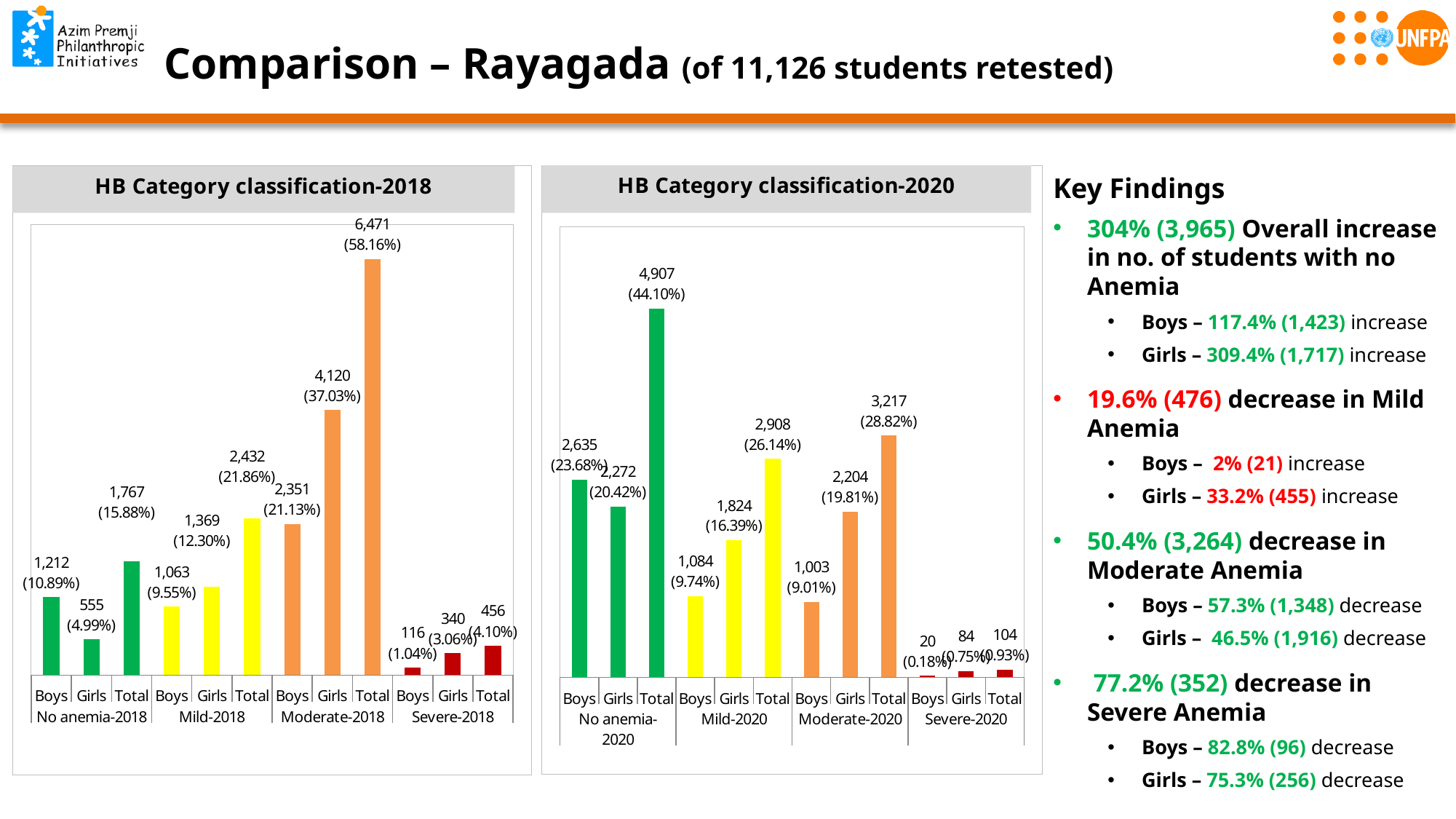
In the HB Category classification-2018 chart, which bar has the highest value? Total, Moderate-2018 In the HB Category classification-2020 chart, what is the value for Boys in Severe-2020? 20 What type of chart is the HB Category classification-2020 chart? Bar chart In the HB Category classification-2020 chart, what is the difference between Girls and Boys in Mild-2020? 740 In the HB Category classification-2020 chart, what is the value for Total in No anemia-2020? 4,907 In the HB Category classification-2018 chart, what percentage is shown for Total in Severe-2018? 4.10% In the HB Category classification-2018 chart, what is the value for Girls in Moderate-2018? 4,120 In the HB Category classification-2020 chart, which bar has the lowest value? Boys, Severe-2020 In the HB Category classification-2018 chart, which is larger: Boys in No anemia-2018 or Boys in Mild-2018? Boys in No anemia-2018 How many bars are plotted in the HB Category classification-2018 chart? 12 In the HB Category classification-2018 chart, what colour are the Severe-2018 bars? Red In the HB Category classification-2020 chart, which is larger: Girls in No anemia-2020 or Girls in Moderate-2020? Girls in No anemia-2020